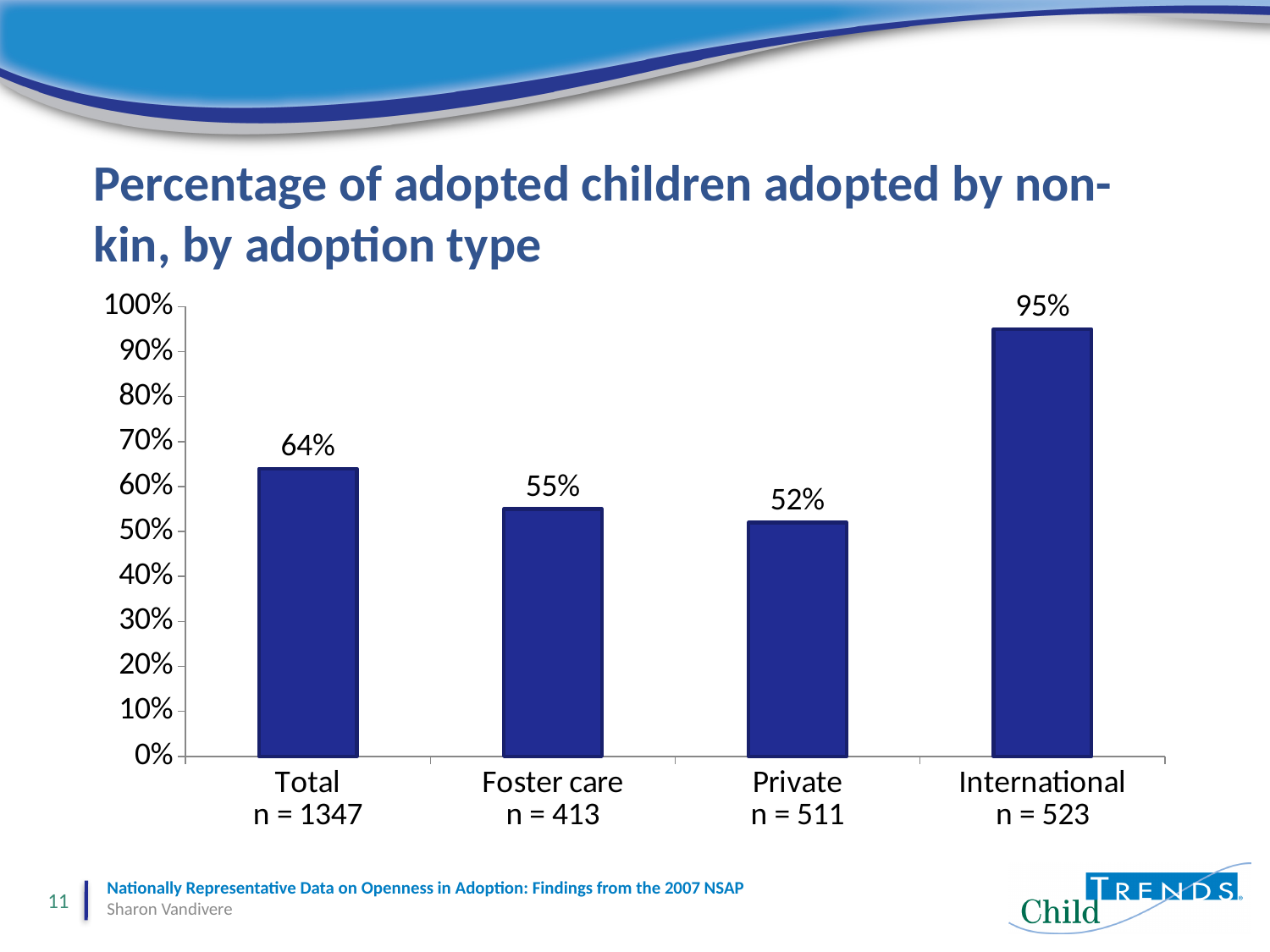
Which adoption type has the highest percentage of children adopted by non-kin? International What is the value for Private adoptions? 52% What is the difference between the Total value and the Foster care value? 9 percentage points What percentage of adopted children were adopted by non-kin in the Total category? 64% What kind of chart is shown on the slide? Bar chart What is the value for Foster care? 55% Which is larger, the value for Foster care or the value for Private? Foster care Is the value for International greater or less than 90%? greater Which adoption type has the lowest percentage of children adopted by non-kin? Private How many adoption type categories are shown on the chart? 4 What is the value for International adoptions? 95% What is the difference in percentage points between International and Private? 43 percentage points